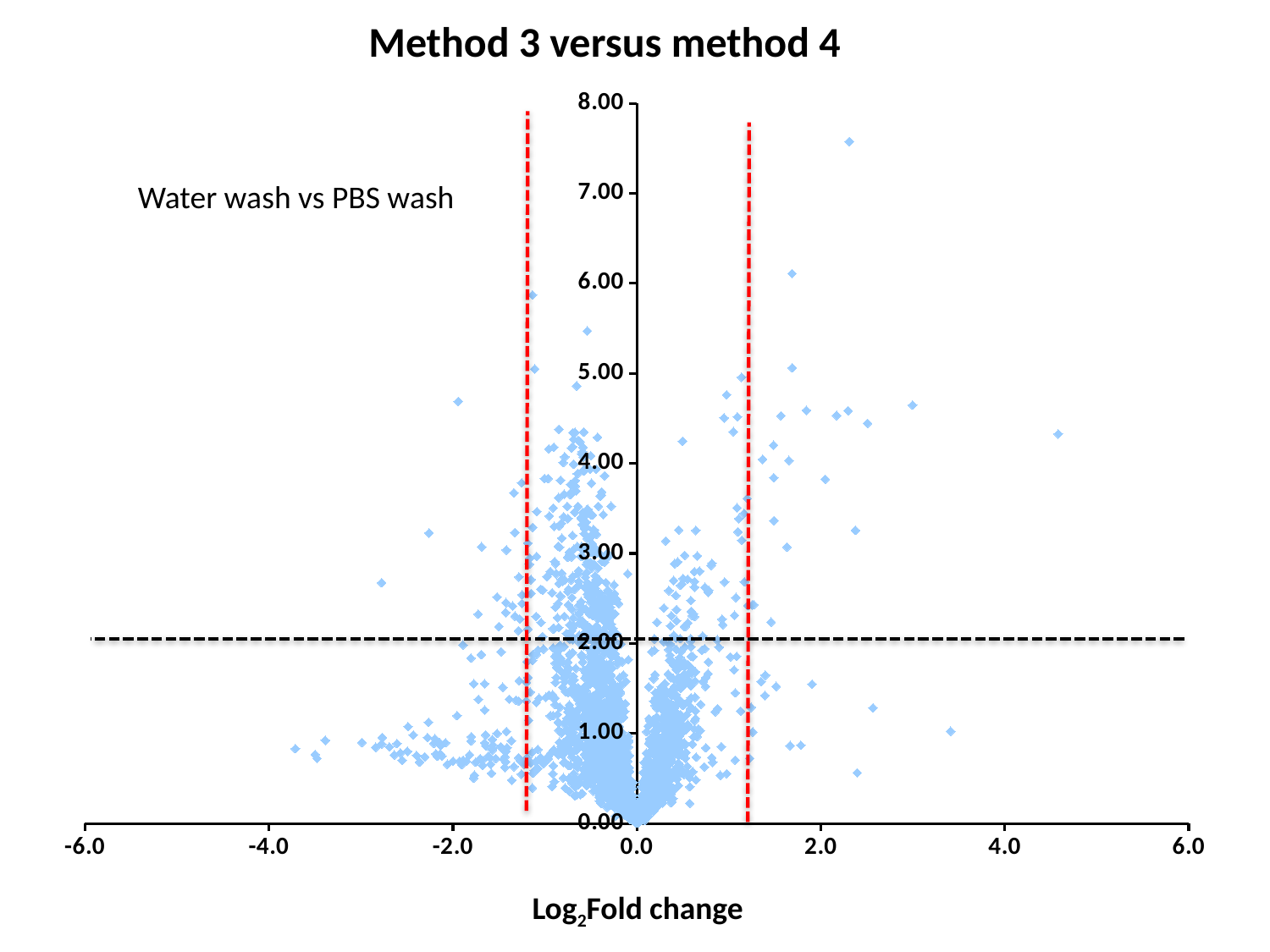
Is the y value of the leftmost point on the chart greater or less than 2.00? less Is the horizontal black dashed line positioned above or below the 3.00 tick on the y axis? below Is the x value of the highest point on the chart greater or less than 2.0? greater What is the title of the chart? Method 3 versus method 4 What is the label of the x axis? Log2Fold change What kind of chart is shown on the slide? scatter chart What is the highest value shown on the y axis? 8.00 What is the lowest value shown on the x axis? -6.0